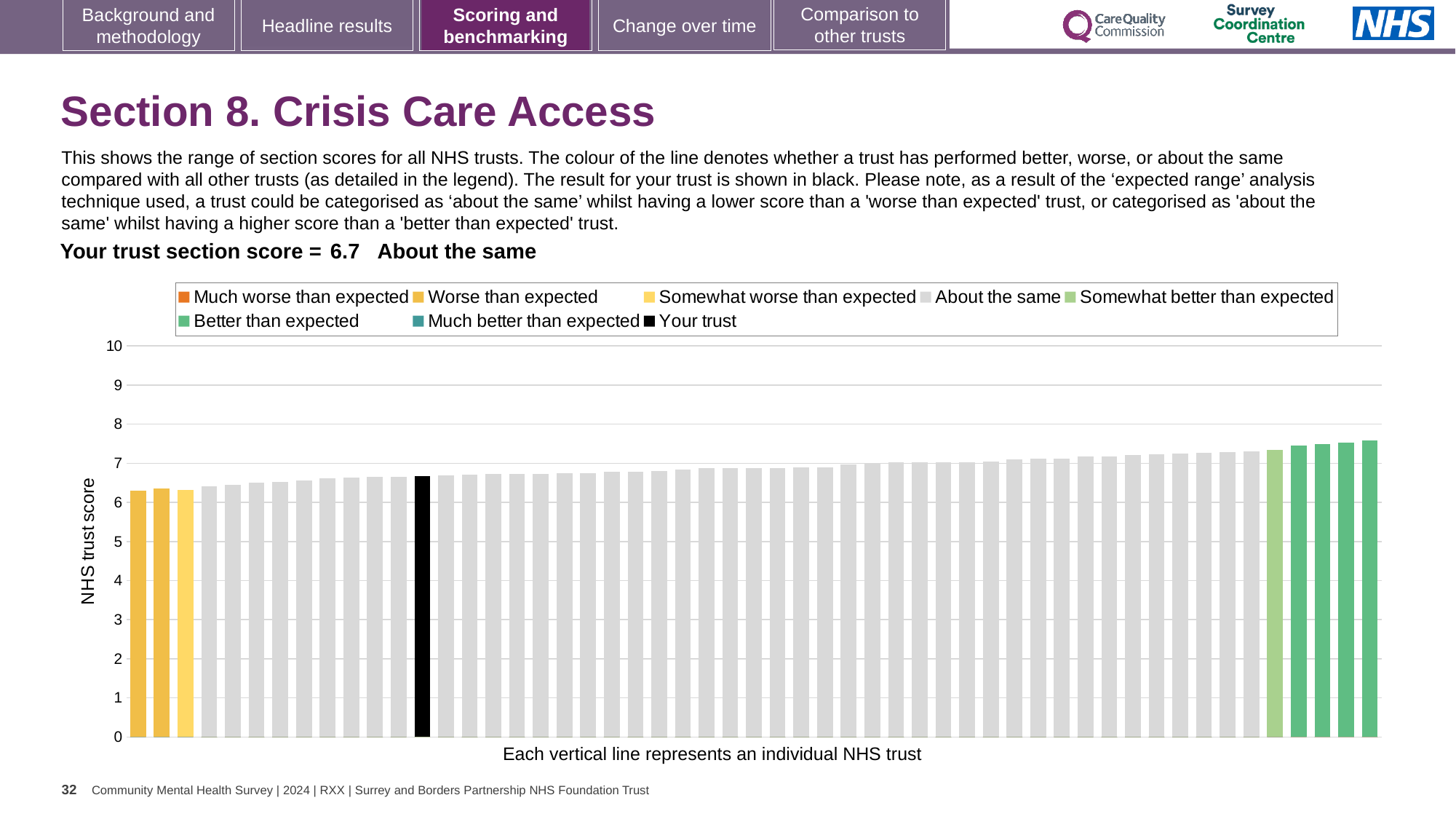
Is the value of the tallest bar greater or less than 8? less How many bars are coloured as 'Better than expected'? 4 Which is larger: the value for your trust's bar or the value of the leftmost bar? your trust's bar What category is your trust's section score placed in, according to the text above the chart? About the same Is the value of the tallest bar greater or less than 7? greater What kind of chart is shown on the slide? bar chart What is the section score for your trust shown on the slide? 6.7 How many bars are coloured as 'Worse than expected'? 2 Is the value of the shortest bar greater or less than 6? greater Do the bar values rise or fall from left to right along the x axis? rise How many entries does the chart legend list? 8